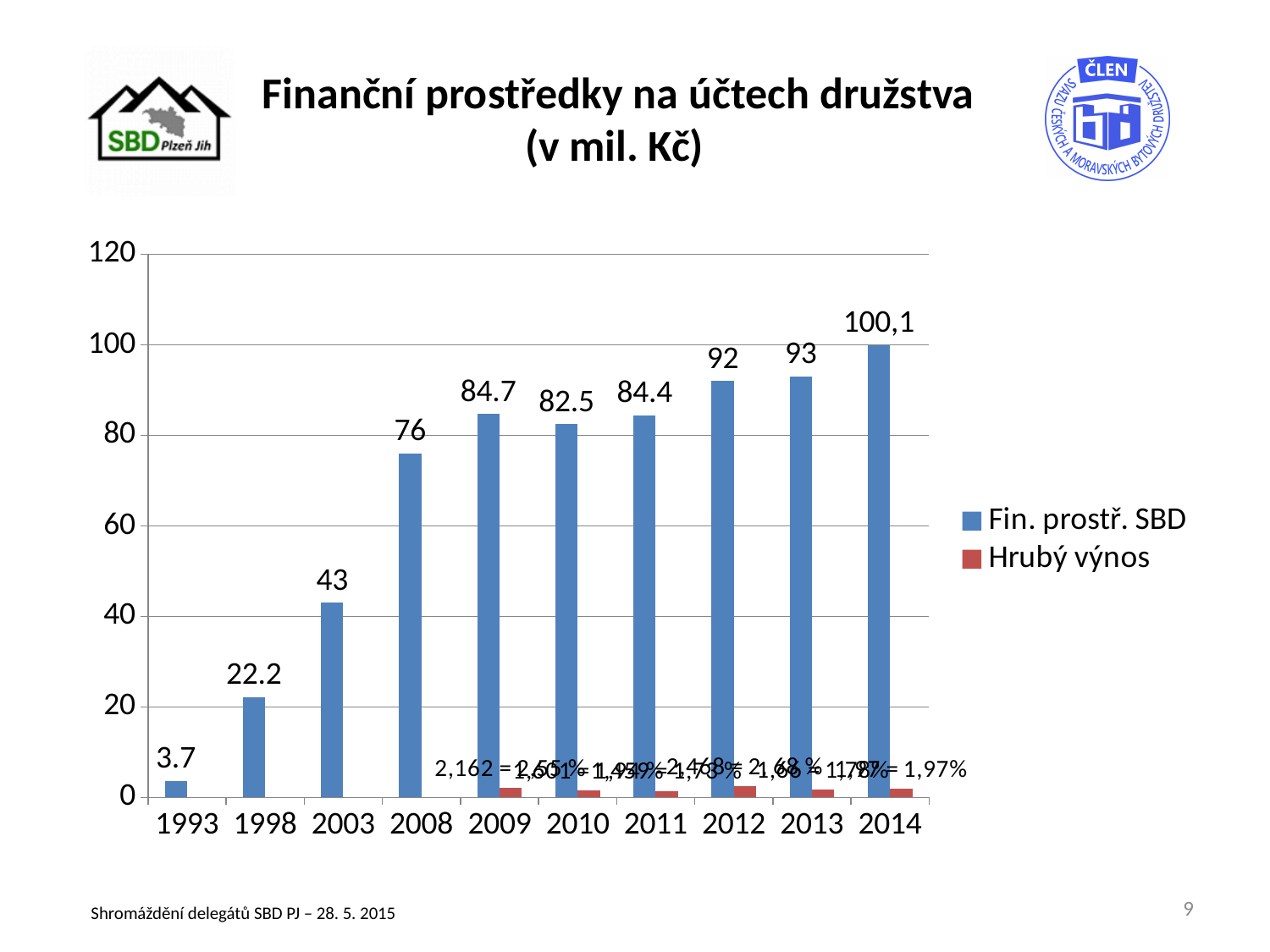
Is the Fin. prostř. SBD value for 2003 greater or less than 40? greater What is the difference between the Fin. prostř. SBD values for 2013 and 2012? 1 What is the value of Fin. prostř. SBD for 2008? 76 What is the difference between the Fin. prostř. SBD values for 2008 and 2003? 33 Which year has the lowest value for Fin. prostř. SBD? 1993 How many series does the legend list? 2 How many years are shown on the x axis? 10 Which year has the highest value for Fin. prostř. SBD? 2014 Which year has a larger Fin. prostř. SBD value, 2009 or 2010? 2009 What is the value of Fin. prostř. SBD for 2014? 100,1 What kind of chart is shown on the slide? bar chart What is the value of Fin. prostř. SBD for 1993? 3.7